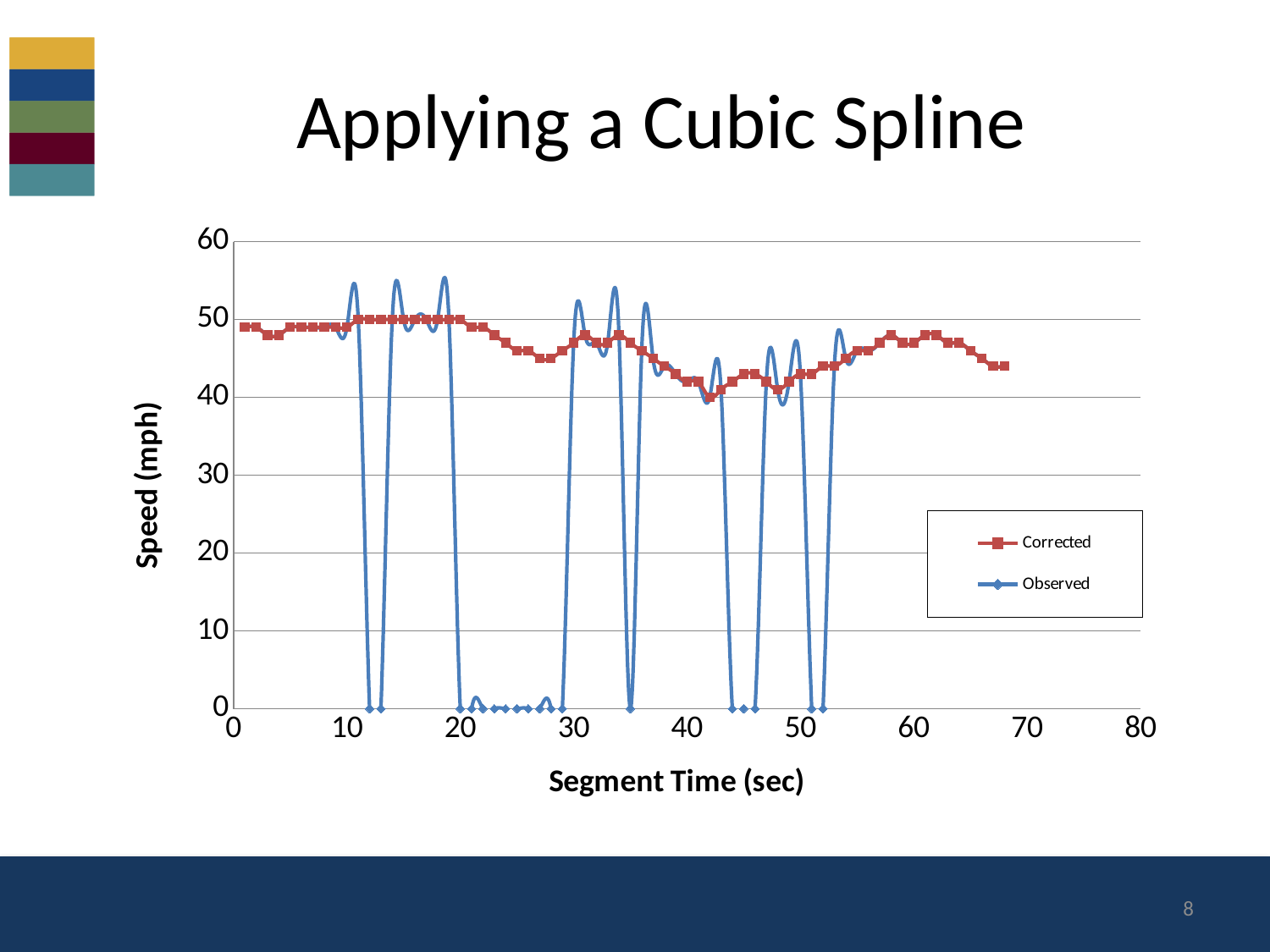
How many series does the legend list? 2 What is the label of the vertical axis? Speed (mph) Is the Corrected speed at a segment time of 40 seconds greater or less than 50? less Is the Corrected speed at a segment time of 60 seconds greater or less than 40? greater What kind of chart is shown on the slide? Line chart Is the Observed speed at a segment time of 24 seconds greater or less than 10? less What is the Observed speed at a segment time of 12 seconds? 0 What are the two series named in the legend? Corrected and Observed Does the Corrected speed rise or fall between segment times of 20 and 40 seconds? Fall What is the lowest value reached by the Observed series? 0 Which is larger: the Corrected speed at 15 seconds or the Corrected speed at 40 seconds? Corrected speed at 15 seconds